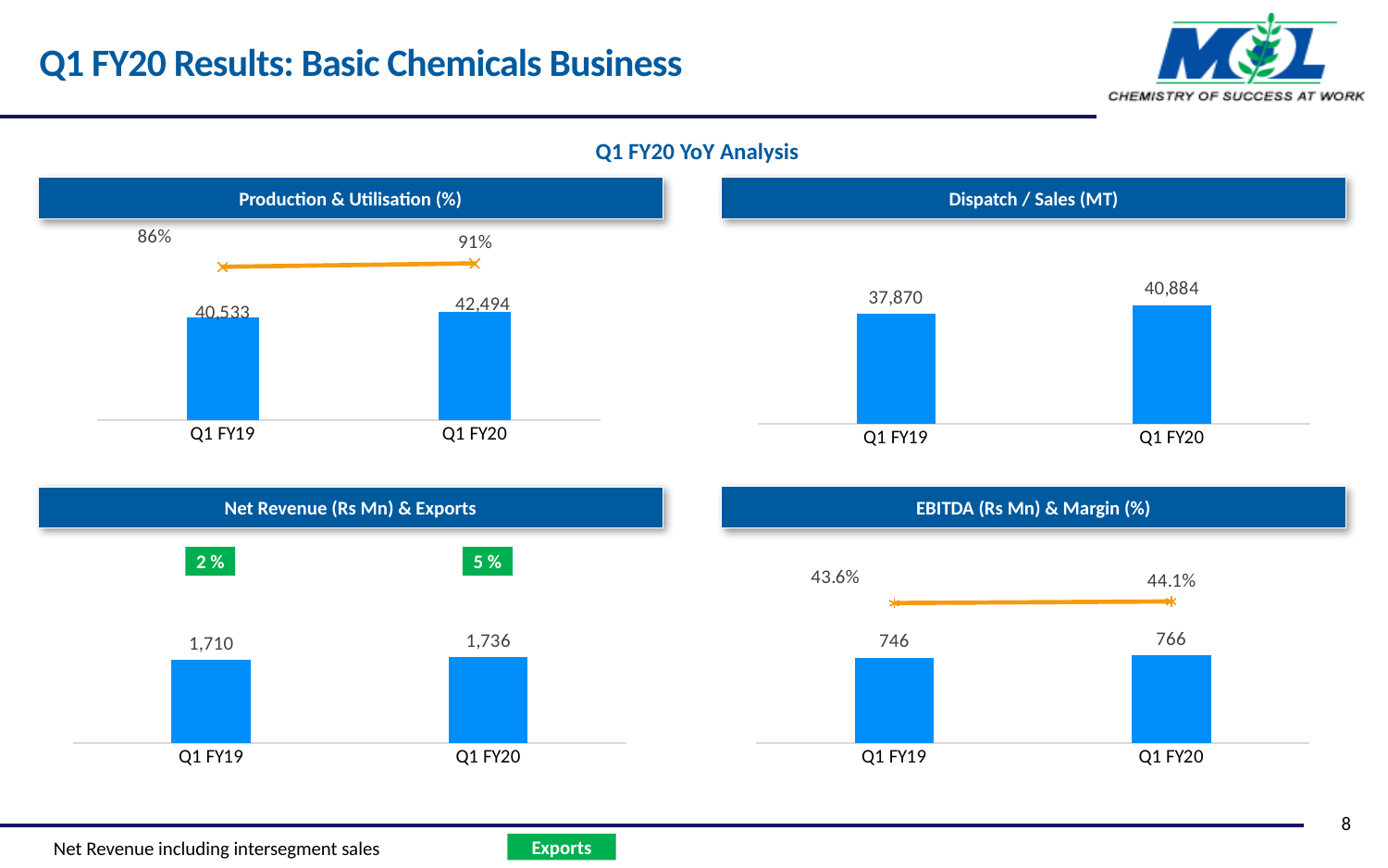
In the EBITDA (Rs Mn) & Margin (%) chart, what is the margin for Q1 FY20? 44.1% In the Production & Utilisation (%) chart, what is the production value for Q1 FY20? 42,494 In the EBITDA (Rs Mn) & Margin (%) chart, what is the difference in EBITDA between Q1 FY20 and Q1 FY19? 20 In the Net Revenue (Rs Mn) & Exports chart, which period has the higher net revenue? Q1 FY20 What type of chart is the Dispatch / Sales (MT) chart? Bar chart In the Net Revenue (Rs Mn) & Exports chart, what is the exports percentage shown for Q1 FY19? 2 % In the Dispatch / Sales (MT) chart, what is the difference between Q1 FY20 and Q1 FY19? 3,014 In the EBITDA (Rs Mn) & Margin (%) chart, what is the EBITDA for Q1 FY19? 746 In the Production & Utilisation (%) chart, what is the utilisation percentage for Q1 FY19? 86% In the Dispatch / Sales (MT) chart, what is the value for Q1 FY19? 37,870 How many periods are shown on the x axis of the Dispatch / Sales (MT) chart? 2 In the Net Revenue (Rs Mn) & Exports chart, what is the net revenue for Q1 FY20? 1,736